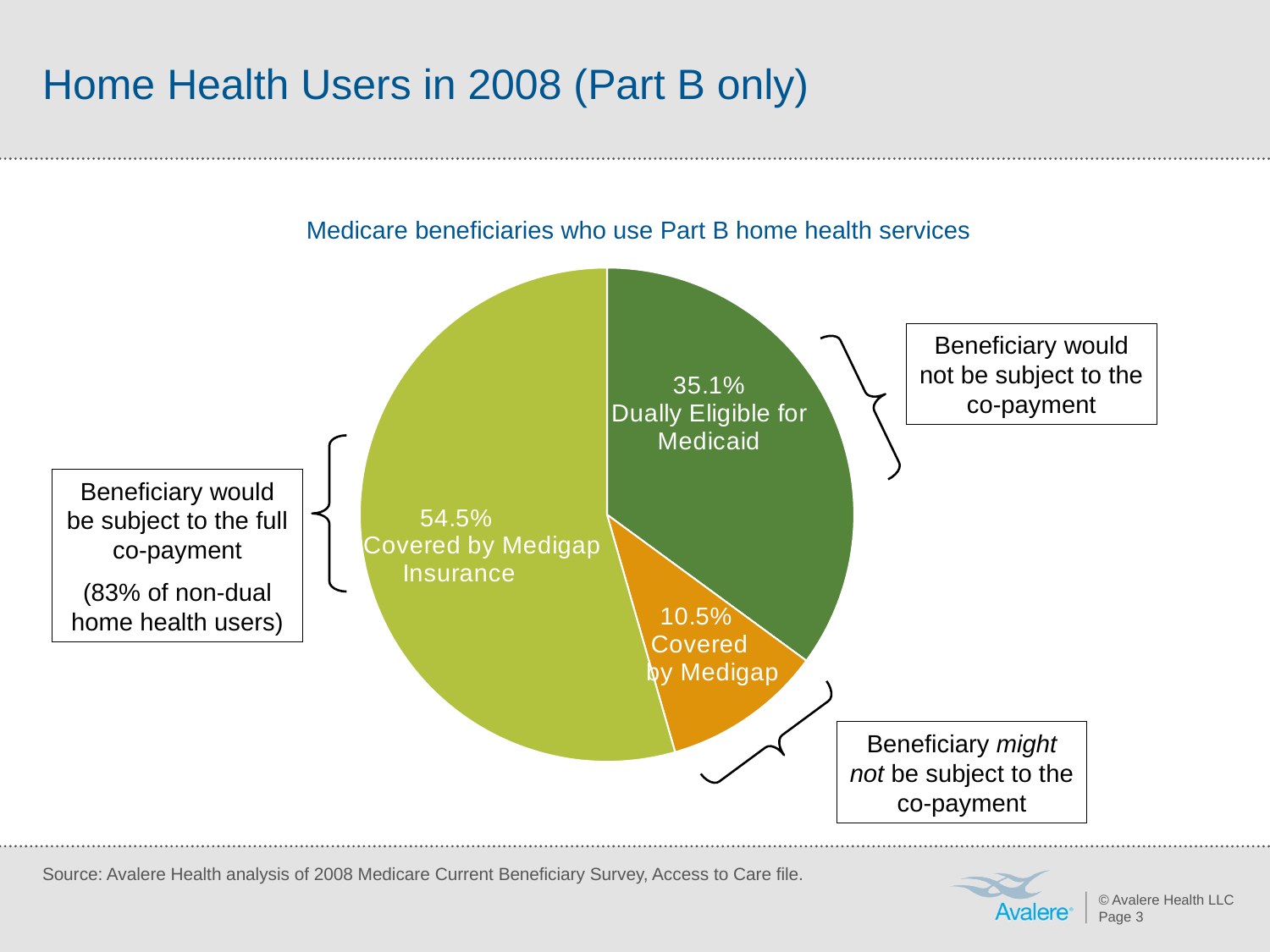
What is the title of the pie chart? Medicare beneficiaries who use Part B home health services How many slices does the pie chart have? 3 What is the difference in percentage points between the Covered by Medigap Insurance slice and the Dually Eligible for Medicaid slice? 19.4 percentage points What colour is the Dually Eligible for Medicaid slice? Dark green What is the difference in percentage points between the Dually Eligible for Medicaid slice and the Covered by Medigap slice? 24.6 percentage points Which slice of the pie chart is the largest? Covered by Medigap Insurance What share of Medicare beneficiaries who use Part B home health services are Dually Eligible for Medicaid? 35.1% What kind of chart is shown on the slide? Pie chart Which slice of the pie chart is the smallest? Covered by Medigap What share of Medicare beneficiaries who use Part B home health services are Covered by Medigap? 10.5% What share of Medicare beneficiaries who use Part B home health services are Covered by Medigap Insurance? 54.5% Which is larger: the Dually Eligible for Medicaid slice or the Covered by Medigap slice? Dually Eligible for Medicaid